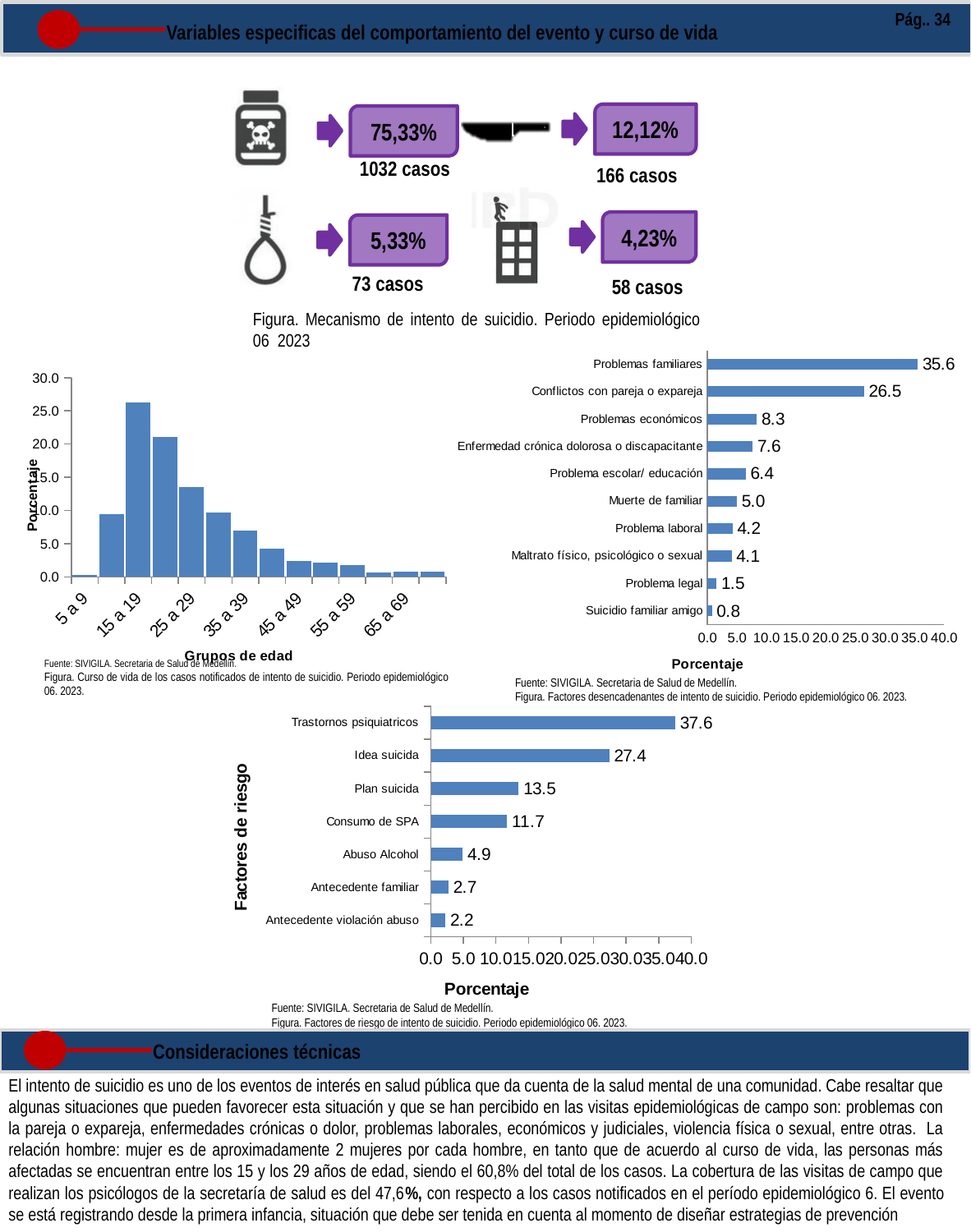
In the chart titled 'Factores de riesgo de intento de suicidio', what is the difference between Idea suicida and Plan suicida? 13.9 In the chart titled 'Factores desencadenantes de intento de suicidio', what is the value for Problemas familiares? 35.6 In the chart titled 'Factores de riesgo de intento de suicidio', which category has the highest value? Trastornos psiquiatricos In the chart titled 'Factores desencadenantes de intento de suicidio', how many categories are shown? 10 In the chart titled 'Factores desencadenantes de intento de suicidio', what is the difference between Problemas familiares and Conflictos con pareja o expareja? 9.1 In the chart titled 'Factores desencadenantes de intento de suicidio', which category has the lowest value? Suicidio familiar amigo In the chart titled 'Factores de riesgo de intento de suicidio', what kind of chart is it? bar chart In the chart titled 'Factores de riesgo de intento de suicidio', how many categories are shown? 7 In the chart titled 'Curso de vida de los casos notificados de intento de suicidio', what is the label of the y axis? Porcentaje In the chart titled 'Factores desencadenantes de intento de suicidio', which is larger: Problemas económicos or Enfermedad crónica dolorosa o discapacitante? Problemas económicos In the chart titled 'Curso de vida de los casos notificados de intento de suicidio', is the value for the 15 a 19 age group greater or less than 20.0? greater In the chart titled 'Factores de riesgo de intento de suicidio', what is the value for Consumo de SPA? 11.7